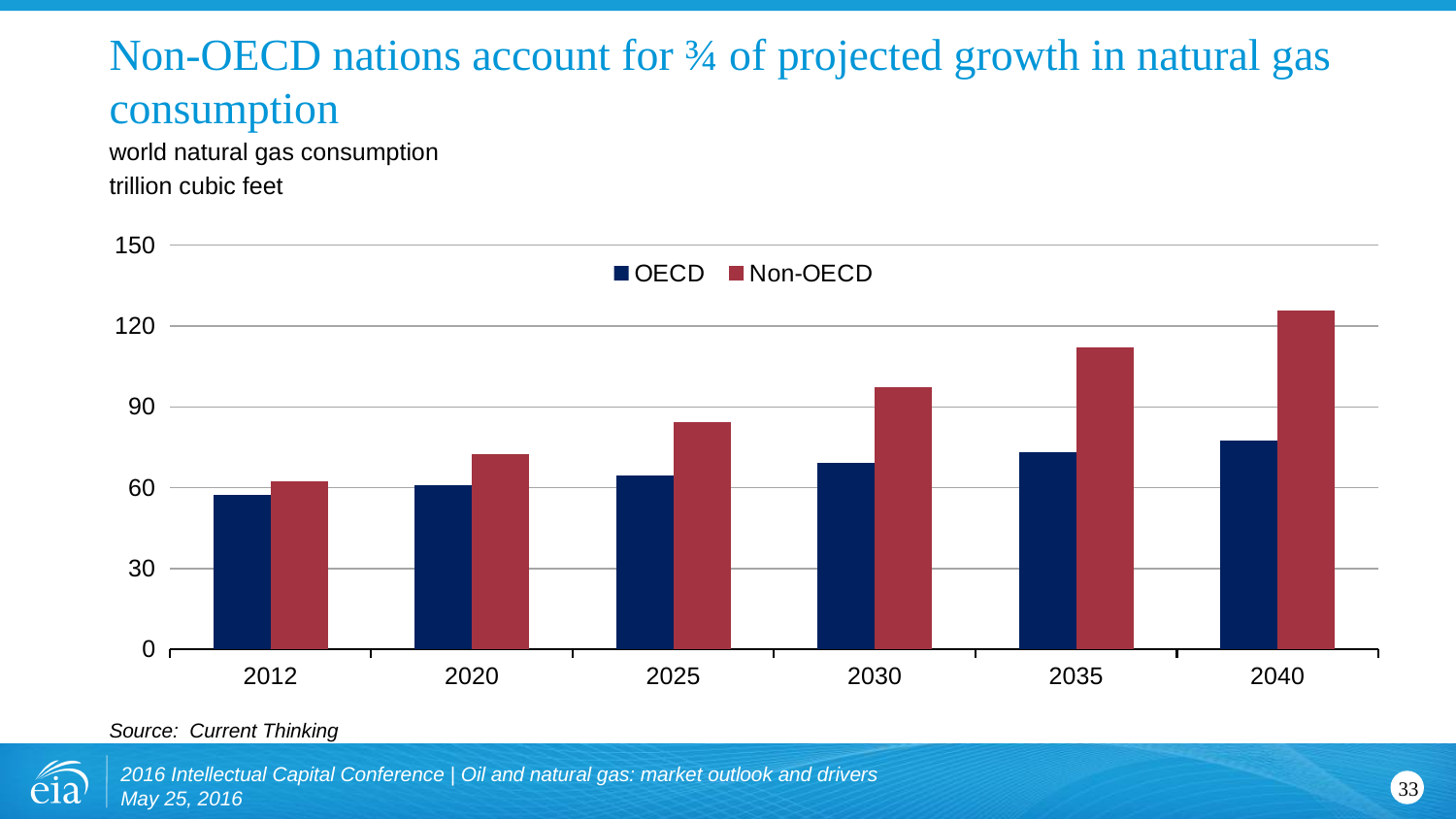
Is the OECD value for 2012 greater or less than 60? less Which colour represents the Non-OECD series? red In 2040, which is larger, OECD or Non-OECD consumption? Non-OECD Is the Non-OECD value for 2040 greater or less than 120? greater Is the Non-OECD value for 2035 greater or less than 90? greater What kind of chart is shown on the slide? bar chart How many years are shown on the x axis? 6 What unit is the y axis measured in? trillion cubic feet Which year has the highest Non-OECD natural gas consumption? 2040 How many series does the legend list? 2 Do the Non-OECD values rise or fall from 2012 to 2040? rise Which year has the lowest OECD natural gas consumption? 2012